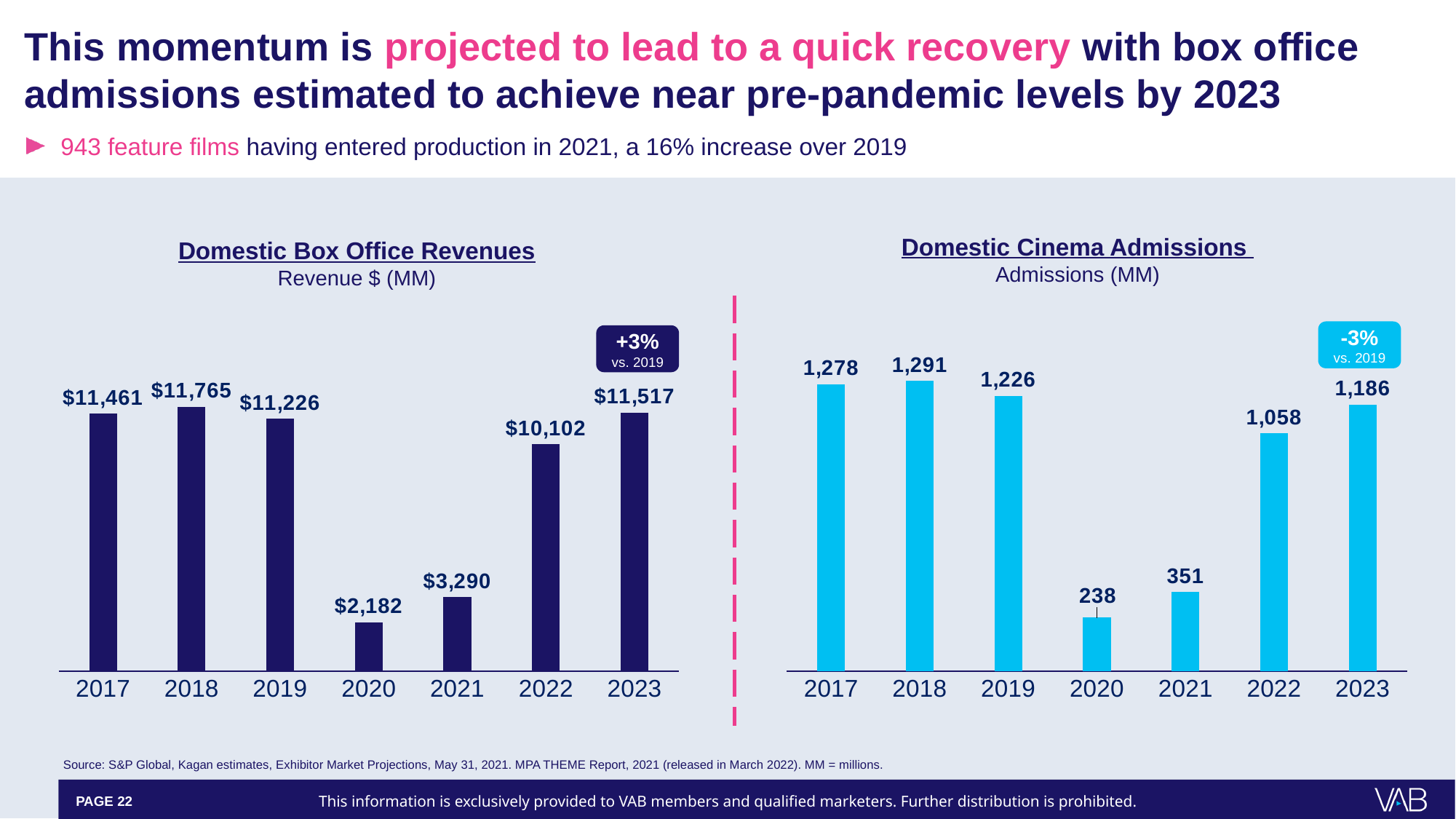
How many years are shown on the x axis of the Domestic Box Office Revenues chart? 7 In the Domestic Box Office Revenues chart, what percentage change vs. 2019 is shown in the callout above the 2023 bar? +3% In the Domestic Box Office Revenues chart, what is the revenue for 2020? $2,182 In the Domestic Cinema Admissions chart, which year has the lowest admissions? 2020 In the Domestic Cinema Admissions chart, what is the value for 2022? 1,058 In the Domestic Box Office Revenues chart, what is the difference between the 2023 and 2022 values? $1,415 In the Domestic Cinema Admissions chart, what is the difference between the 2019 and 2023 values? 40 What kind of chart is the Domestic Cinema Admissions chart? Bar chart What unit is given in the subtitle of the Domestic Cinema Admissions chart? Admissions (MM) In the Domestic Cinema Admissions chart, which is larger, the value for 2017 or the value for 2023? 2017 In the Domestic Box Office Revenues chart, which year has the highest revenue? 2018 In the Domestic Box Office Revenues chart, do the values rise or fall from 2020 to 2023? Rise